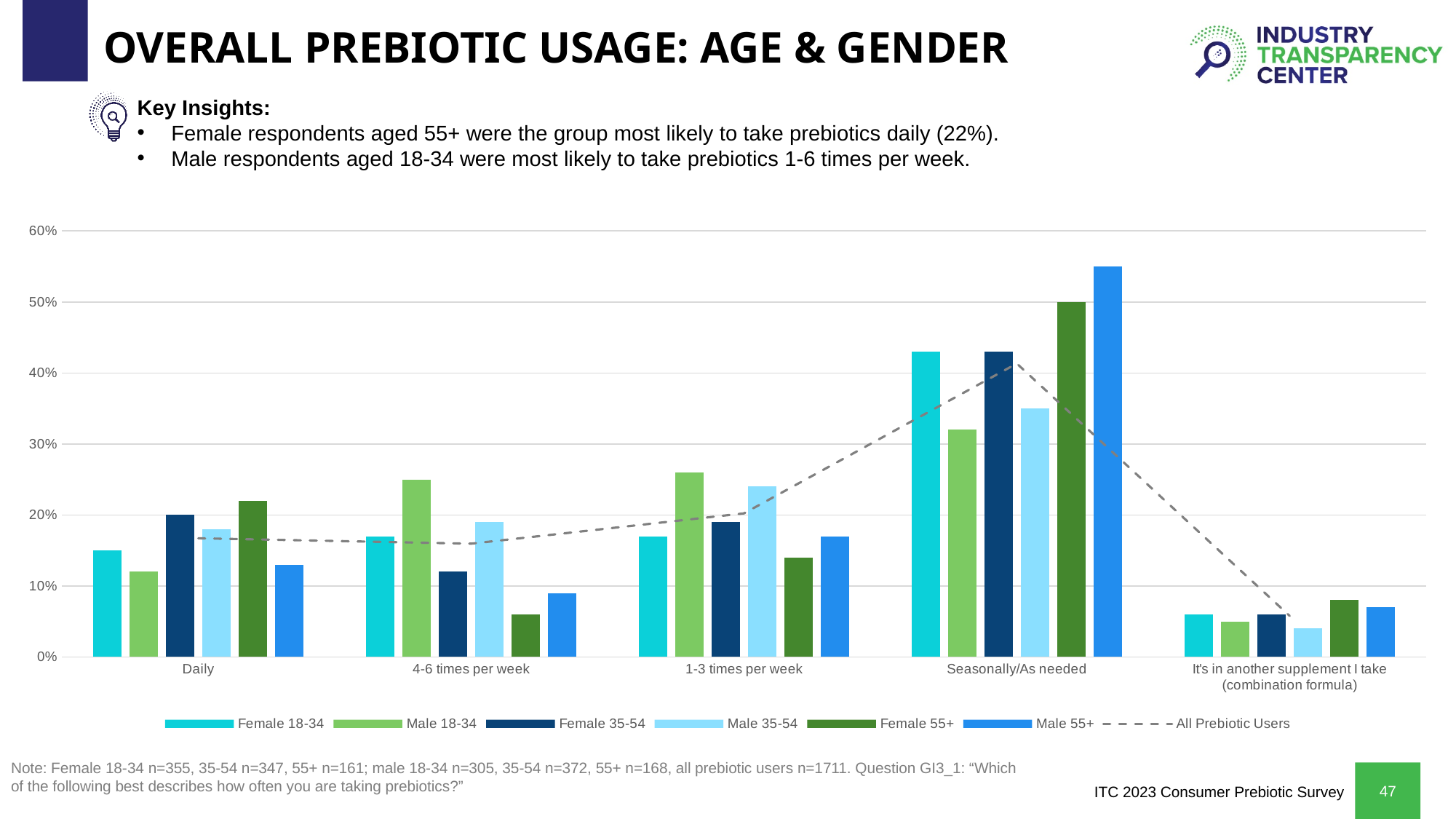
Which series has the lowest bar in the 4-6 times per week category? Female 55+ Which series has the highest bar in the Seasonally/As needed category? Male 55+ Is the value for Male 55+ in the Seasonally/As needed category greater or less than 50%? greater Which series has the highest bar in the Daily category? Female 55+ What does the dashed grey line in the chart represent? All Prebiotic Users In the Seasonally/As needed category, which is larger: Female 18-34 or Male 18-34? Female 18-34 Is the value for Female 55+ in the 4-6 times per week category greater or less than 10%? less How many frequency categories are shown along the x axis? 5 What is the value for Female 55+ in the Seasonally/As needed category? 50% Is the value for Male 18-34 in the 4-6 times per week category greater or less than 20%? greater What type of chart is shown on the slide? Combination bar and line chart How many series does the legend list? 7